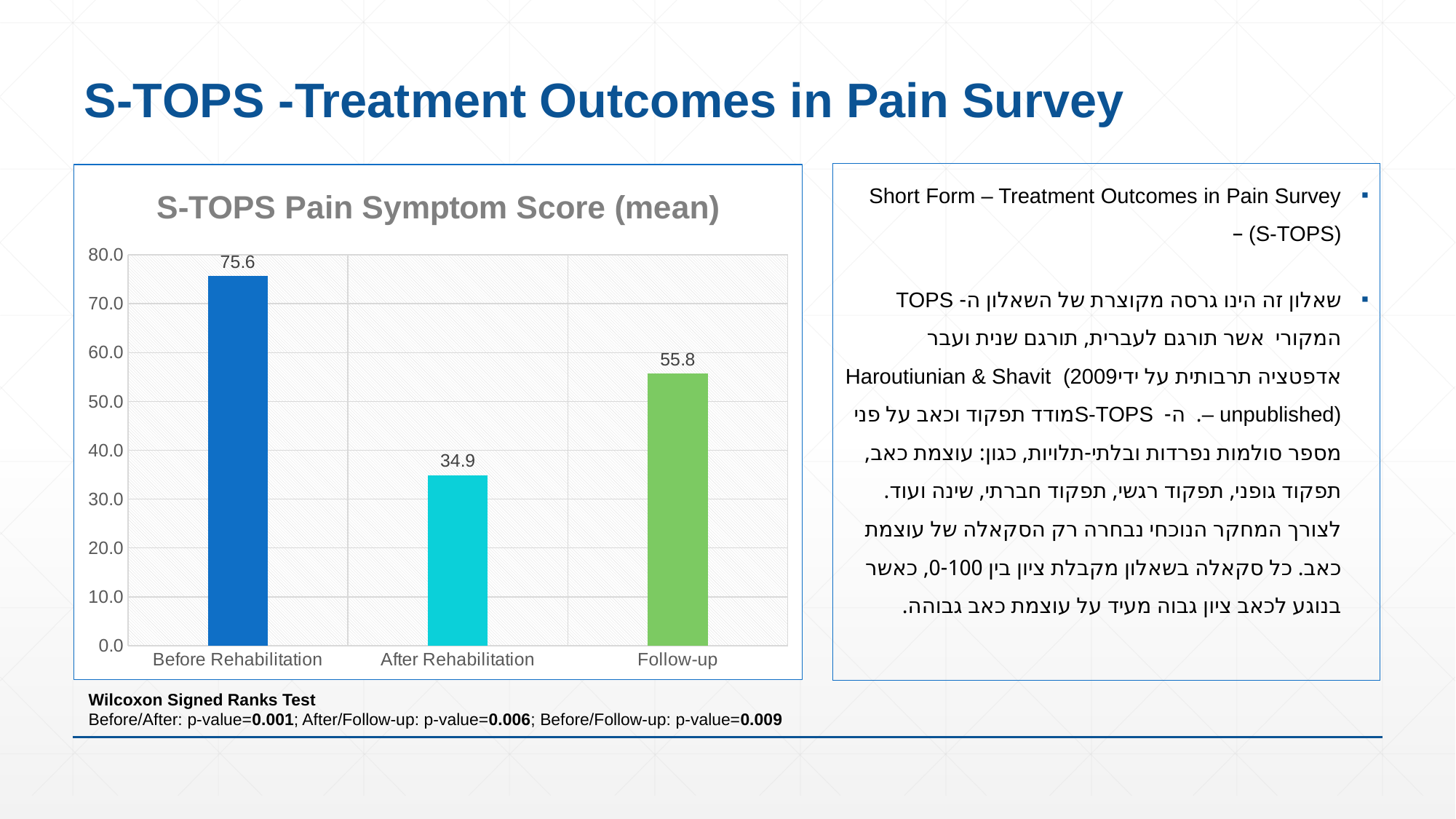
What is the S-TOPS Pain Symptom Score (mean) for After Rehabilitation? 34.9 What is the difference between the Before Rehabilitation and After Rehabilitation scores? 40.7 What is the S-TOPS Pain Symptom Score (mean) for Before Rehabilitation? 75.6 Is the value for Follow-up greater or less than 60.0? less What is the S-TOPS Pain Symptom Score (mean) at Follow-up? 55.8 What kind of chart is shown on the slide? bar chart Which is larger, the Follow-up score or the After Rehabilitation score? Follow-up Which category has the lowest S-TOPS Pain Symptom Score (mean)? After Rehabilitation Which category has the highest S-TOPS Pain Symptom Score (mean)? Before Rehabilitation How many categories are shown on the x axis of the chart? 3 What is the difference between the Follow-up and After Rehabilitation scores? 20.9 What is the title of the chart? S-TOPS Pain Symptom Score (mean)